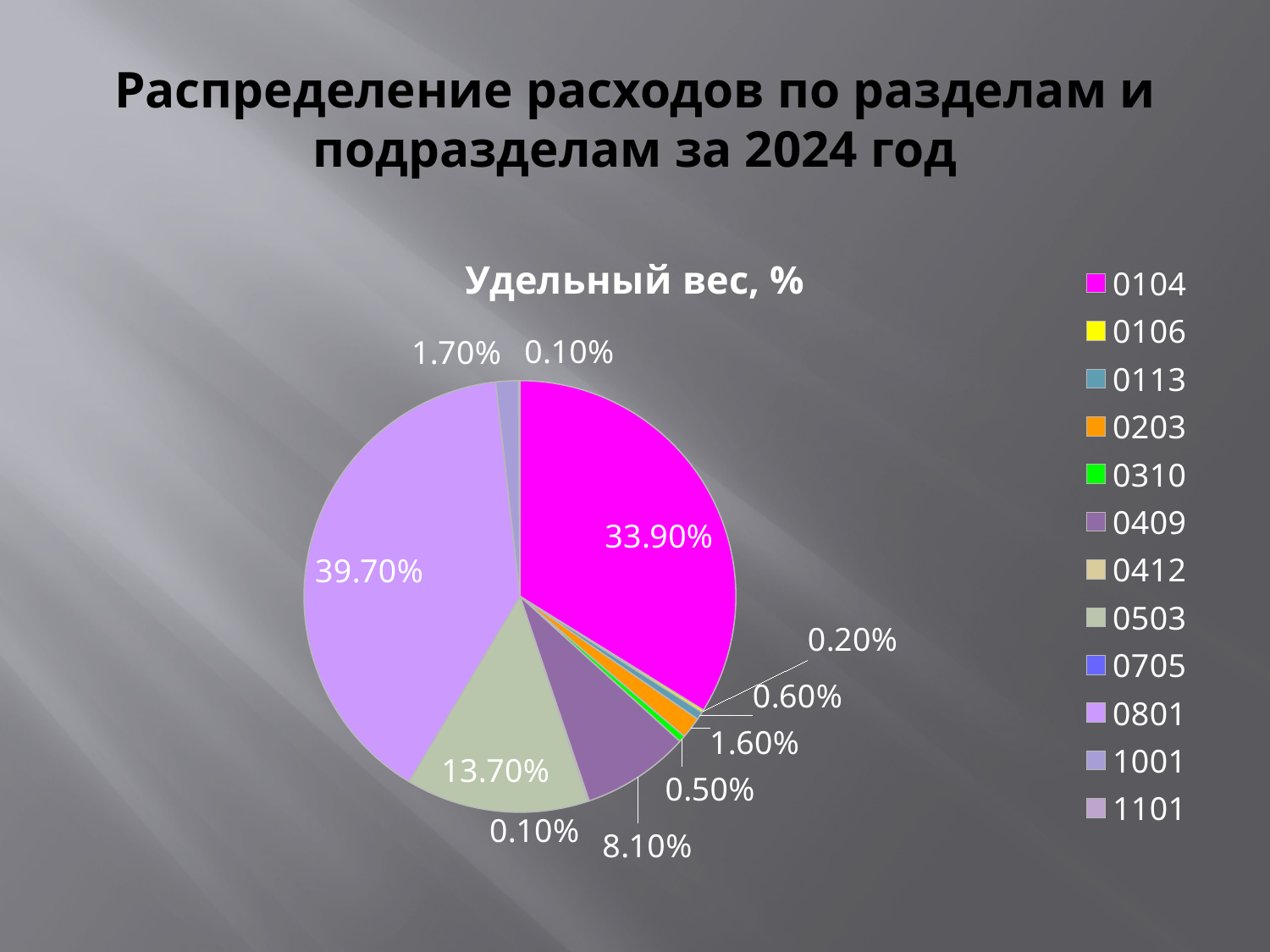
What is the difference between the shares of 0801 and 0104? 5.80% What is the share for category 0503? 13.70% What is the share for category 0409? 8.10% What is the share for category 0801? 39.70% Which category has the largest share of the pie? 0801 What kind of chart is shown on the slide? pie chart What colour is the slice for category 0104? magenta How many categories does the chart legend list? 12 What is the share for category 0104? 33.90% What is the title of the chart? Удельный вес, % What is the difference between the shares of 0503 and 0409? 5.60% Which is larger, the share of 0503 or the share of 0409? 0503